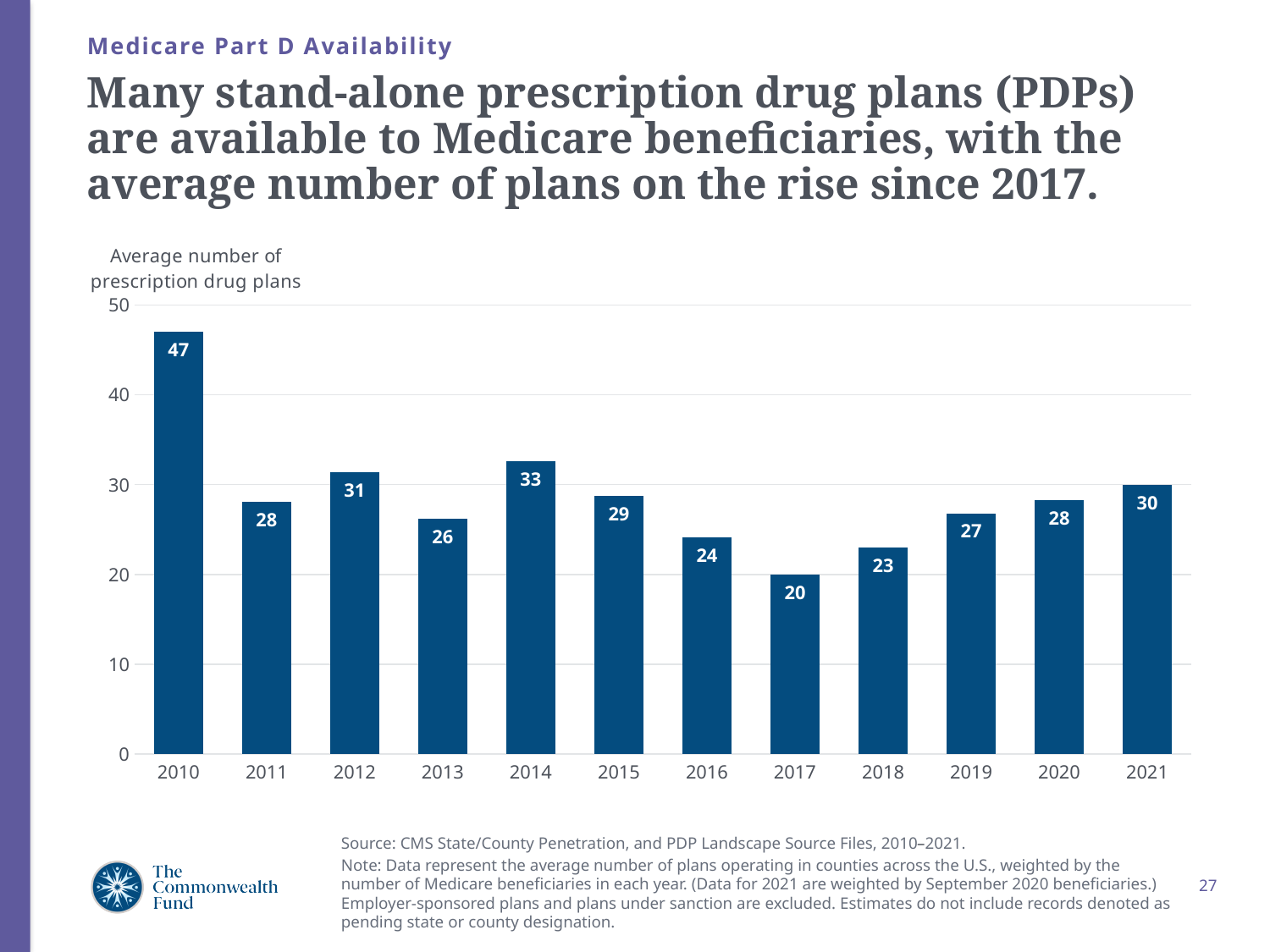
Which year has a higher average number of plans, 2012 or 2015? 2012 Which year has the highest average number of prescription drug plans? 2010 What kind of chart is shown on the slide? Bar chart What is the difference between the average number of plans in 2010 and in 2017? 27 Which year has the lowest average number of prescription drug plans? 2017 What is the average number of prescription drug plans in 2010? 47 Do the values rise or fall from 2017 to 2021? Rise What is the average number of prescription drug plans in 2017? 20 What is the average number of prescription drug plans in 2021? 30 How many years are shown on the x axis of the chart? 12 What is the difference between the average number of plans in 2014 and in 2013? 7 Is the value for 2016 greater or less than 30? less